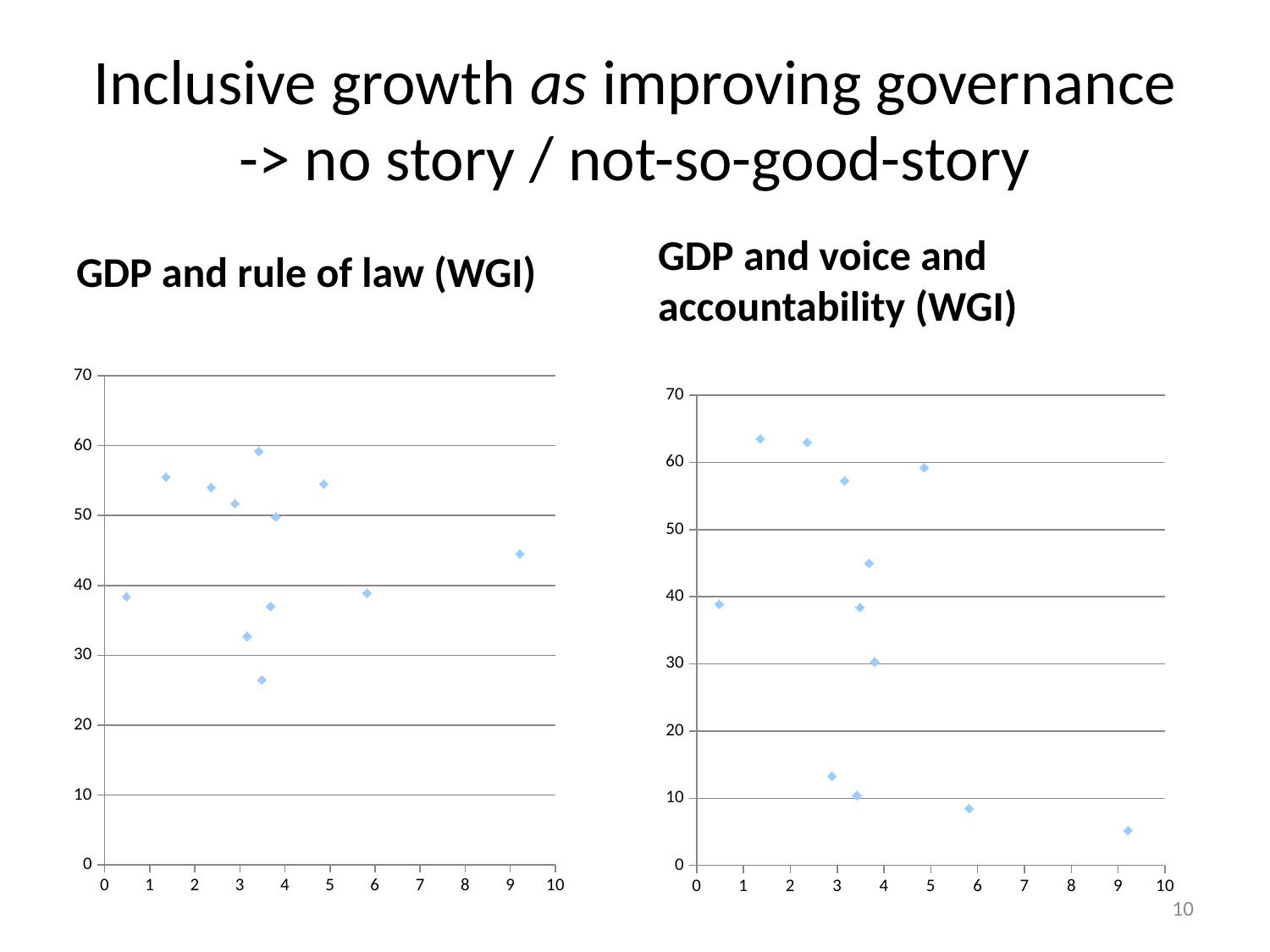
What kind of chart is the 'GDP and rule of law (WGI)' chart? scatter chart How many data points are plotted in the 'GDP and voice and accountability (WGI)' chart? 12 What kind of chart is the 'GDP and voice and accountability (WGI)' chart? scatter chart In the 'GDP and rule of law (WGI)' chart, is the lowest plotted point above or below 30 on the vertical axis? below In the 'GDP and rule of law (WGI)' chart, is the vertical value of the point at x = 9 greater or less than 40? greater In the 'GDP and voice and accountability (WGI)' chart, which point has the lowest vertical value: the one at x = 6 or the one at x = 9? the one at x = 9 In the 'GDP and voice and accountability (WGI)' chart, is the vertical value of the point near x = 1.4 greater or less than 60? greater In the 'GDP and voice and accountability (WGI)' chart, what is the highest value shown on the horizontal axis? 10 How many data points are plotted in the 'GDP and rule of law (WGI)' chart? 12 Do the points in the 'GDP and voice and accountability (WGI)' chart generally rise or fall as the horizontal value increases? fall In the 'GDP and rule of law (WGI)' chart, what is the highest value shown on the vertical axis? 70